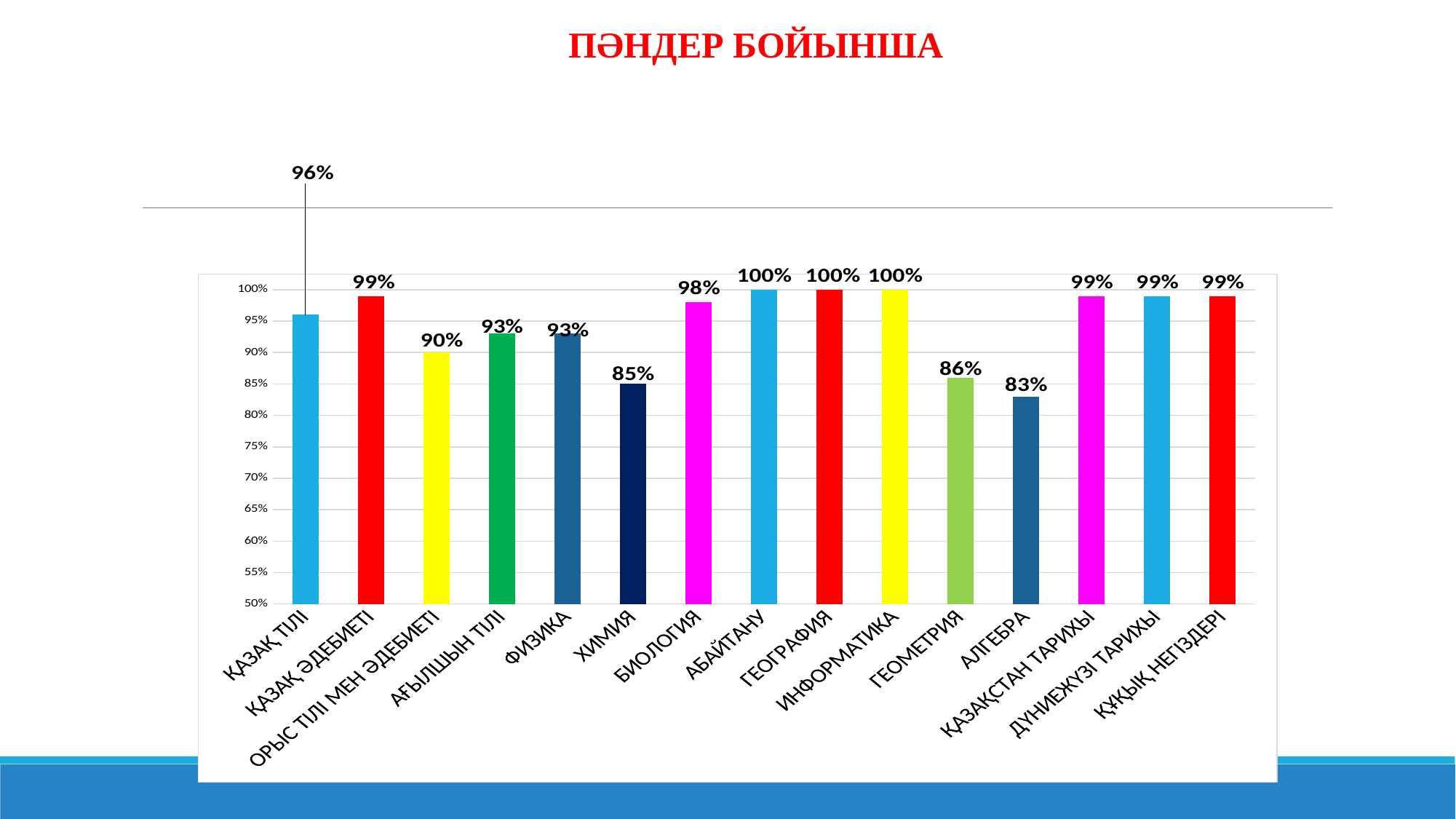
How many categories are shown on the chart? 15 Which is larger, the value for ФИЗИКА or the value for ХИМИЯ? ФИЗИКА What is the difference between the values for ҚАЗАҚ ӘДЕБИЕТІ and ОРЫС ТІЛІ МЕН ӘДЕБИЕТІ? 9% What is the value for БИОЛОГИЯ? 98% What is the title of the slide? ПӘНДЕР БОЙЫНША What is the value for ҚАЗАҚ ТІЛІ? 96% Which category has the lowest value? АЛГЕБРА What is the difference between the values for ГЕОГРАФИЯ and АЛГЕБРА? 17% What is the value for ХИМИЯ? 85% What kind of chart is shown on the slide? Bar chart What is the value for ГЕОМЕТРИЯ? 86% Which is larger, the value for ҚАЗАҚ ТІЛІ or the value for ҚАЗАҚСТАН ТАРИХЫ? ҚАЗАҚСТАН ТАРИХЫ